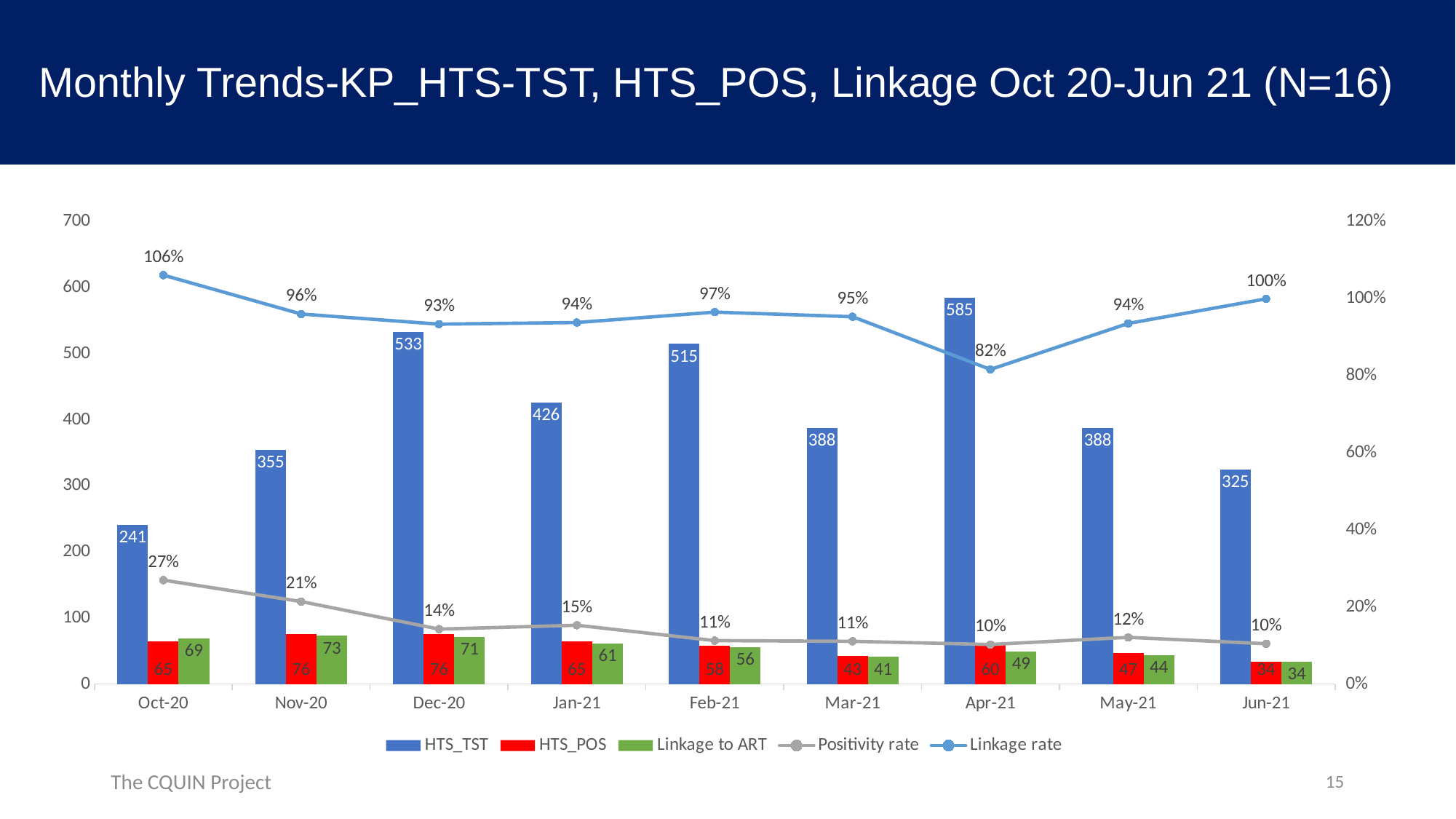
Does the Positivity rate generally rise or fall from Oct-20 to Jun-21? fall How many series does the legend list? 5 Which month has the highest HTS_TST value? Apr-21 How many months are shown on the x axis? 9 What is the HTS_TST value for Apr-21? 585 Which month has the lowest Linkage rate? Apr-21 What is the Positivity rate for Oct-20? 27% What is the difference between the HTS_TST values for Dec-20 and Oct-20? 292 What is the Linkage rate for Apr-21? 82% Which is larger, the HTS_POS value for Feb-21 or for Mar-21? Feb-21 What is the HTS_POS value for Nov-20? 76 What is the Linkage to ART value for Jun-21? 34